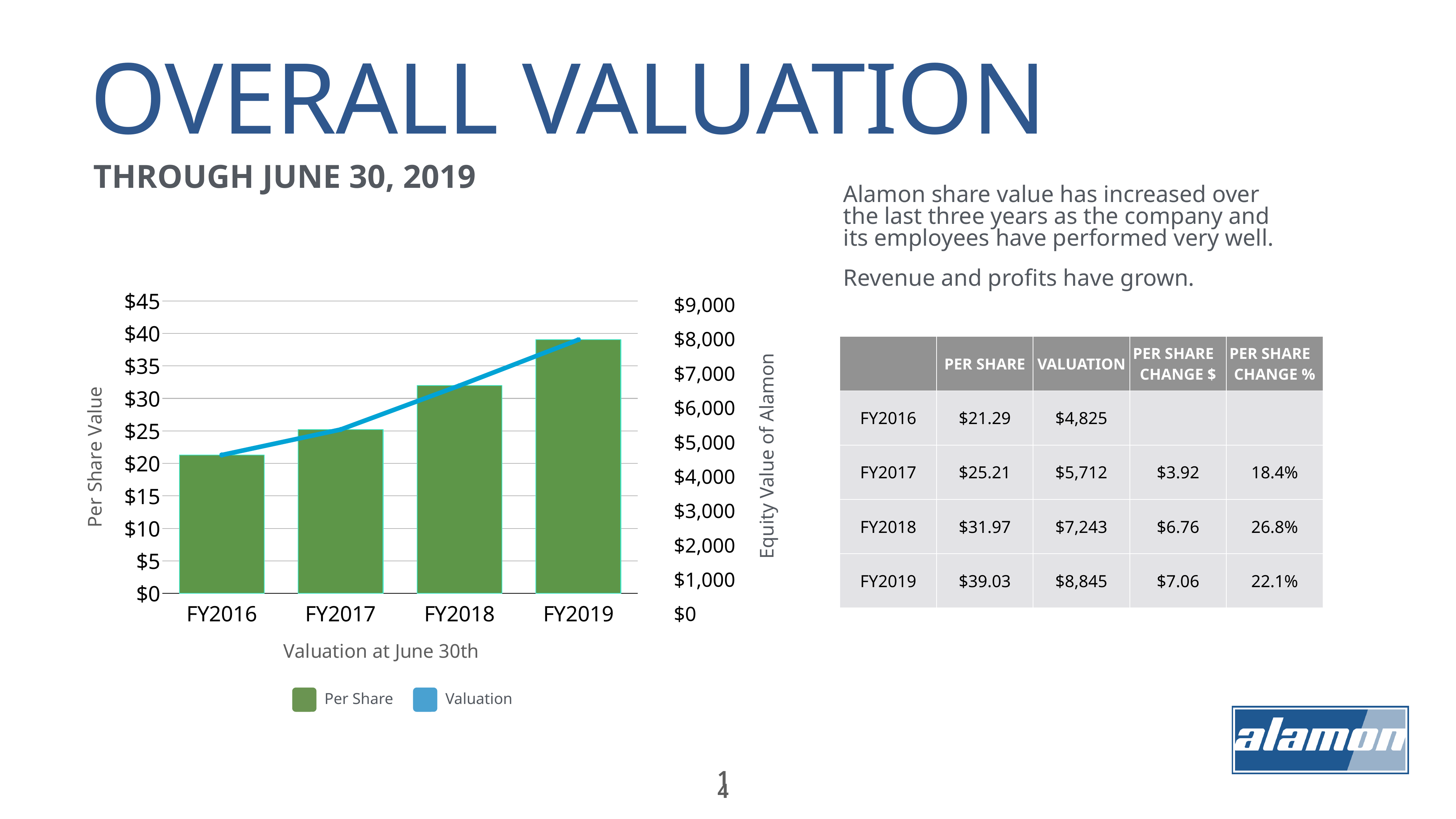
Which fiscal year has the highest Per Share value in the chart? FY2019 What is the Per Share value for FY2019, as printed in the table on the slide? $39.03 Is the Per Share value for FY2018 greater or less than $30? greater How many fiscal years are shown on the x axis of the chart? 4 Which fiscal year has the lowest Per Share value in the chart? FY2016 What kind of chart is shown on the slide? A combined bar and line chart How many series does the chart legend list? 2 What is the label of the right-hand vertical axis of the chart? Equity Value of Alamon Is the Valuation for FY2019 greater or less than $8,000? greater Is the Per Share value for FY2017 greater or less than $30? less Which is larger, the Per Share value for FY2017 or for FY2018? FY2018 Do the Per Share values rise or fall from FY2016 to FY2019? Rise